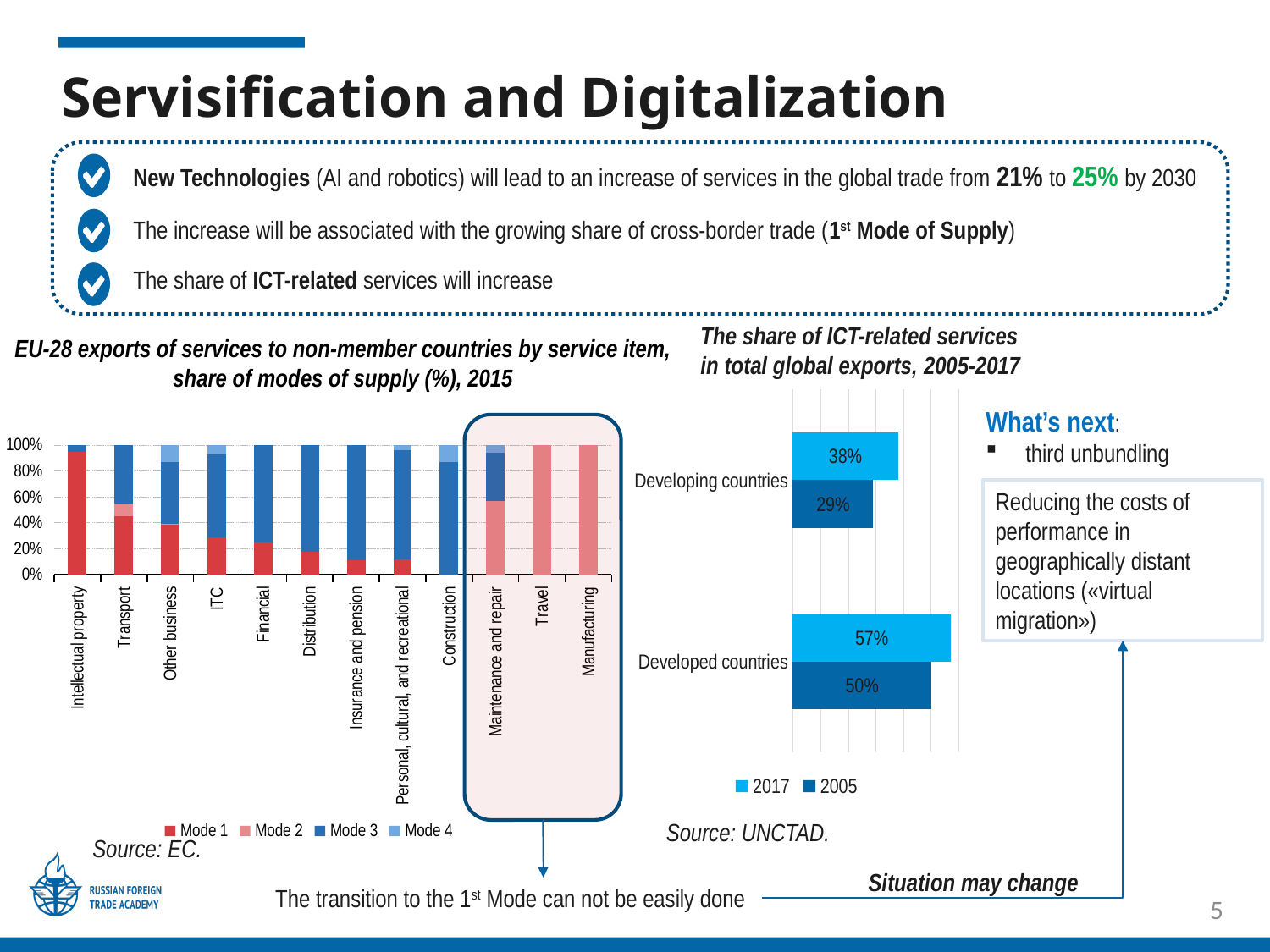
In the chart 'The share of ICT-related services in total global exports, 2005-2017', what is the value for Developing countries in 2005? 29% In the chart 'EU-28 exports of services to non-member countries by service item, share of modes of supply (%), 2015', is the Mode 1 share for Intellectual property greater or less than 80%? greater In the chart 'The share of ICT-related services in total global exports, 2005-2017', by how many percentage points did the share for Developed countries change from 2005 to 2017? 7 percentage points In the chart 'The share of ICT-related services in total global exports, 2005-2017', what is the value for Developing countries in 2017? 38% In the chart 'EU-28 exports of services to non-member countries by service item, share of modes of supply (%), 2015', how many service items are shown on the x axis? 12 In the chart 'The share of ICT-related services in total global exports, 2005-2017', which is larger: Developed countries in 2017 or Developing countries in 2017? Developed countries in 2017 In the chart 'EU-28 exports of services to non-member countries by service item, share of modes of supply (%), 2015', how many series does the legend list? 4 In the chart 'The share of ICT-related services in total global exports, 2005-2017', what is the value for Developed countries in 2005? 50% In the chart 'The share of ICT-related services in total global exports, 2005-2017', by how many percentage points did the share for Developing countries change from 2005 to 2017? 9 percentage points What kind of chart is 'EU-28 exports of services to non-member countries by service item, share of modes of supply (%), 2015'? Stacked bar chart In the chart 'The share of ICT-related services in total global exports, 2005-2017', which bar has the highest value? Developed countries, 2017 (57%) In the chart 'The share of ICT-related services in total global exports, 2005-2017', how many series does the legend list? 2